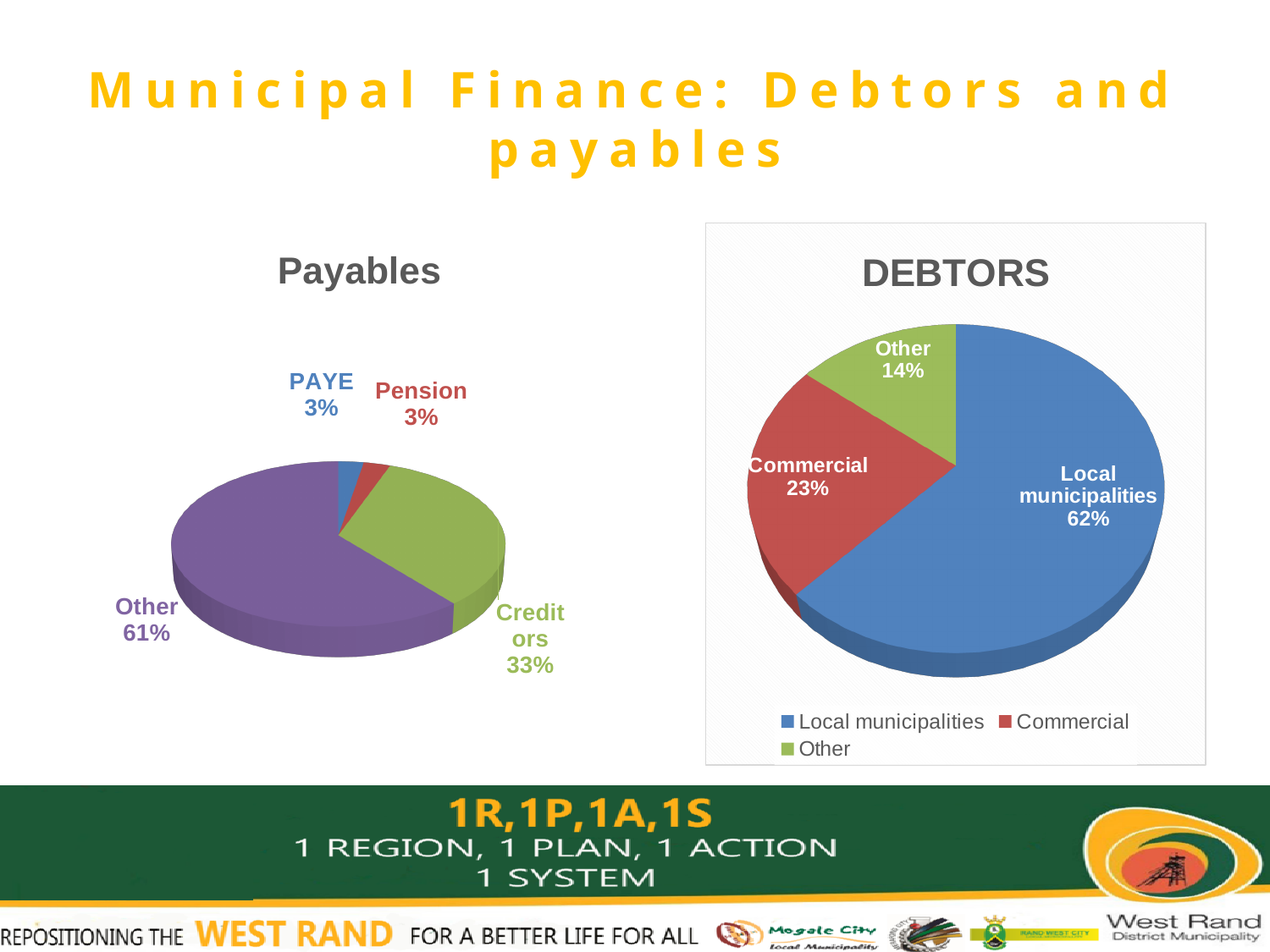
In the Payables chart, what share does Other have? 61% What kind of chart is the DEBTORS chart? Pie chart In the DEBTORS chart, what is the difference between the Local municipalities share and the Commercial share? 39 percentage points In the Payables chart, what is the difference between the Other share and the Creditors share? 28 percentage points In the Payables chart, what share does Creditors have? 33% How many categories does the Payables chart show? 4 In the DEBTORS chart, what share do Local municipalities have? 62% In the Payables chart, which category has the largest share? Other In the DEBTORS chart, what share does Commercial have? 23% In the DEBTORS chart, which is larger, Commercial or Other? Commercial In the Payables chart, what share does PAYE have? 3% In the DEBTORS chart, which category has the smallest share? Other